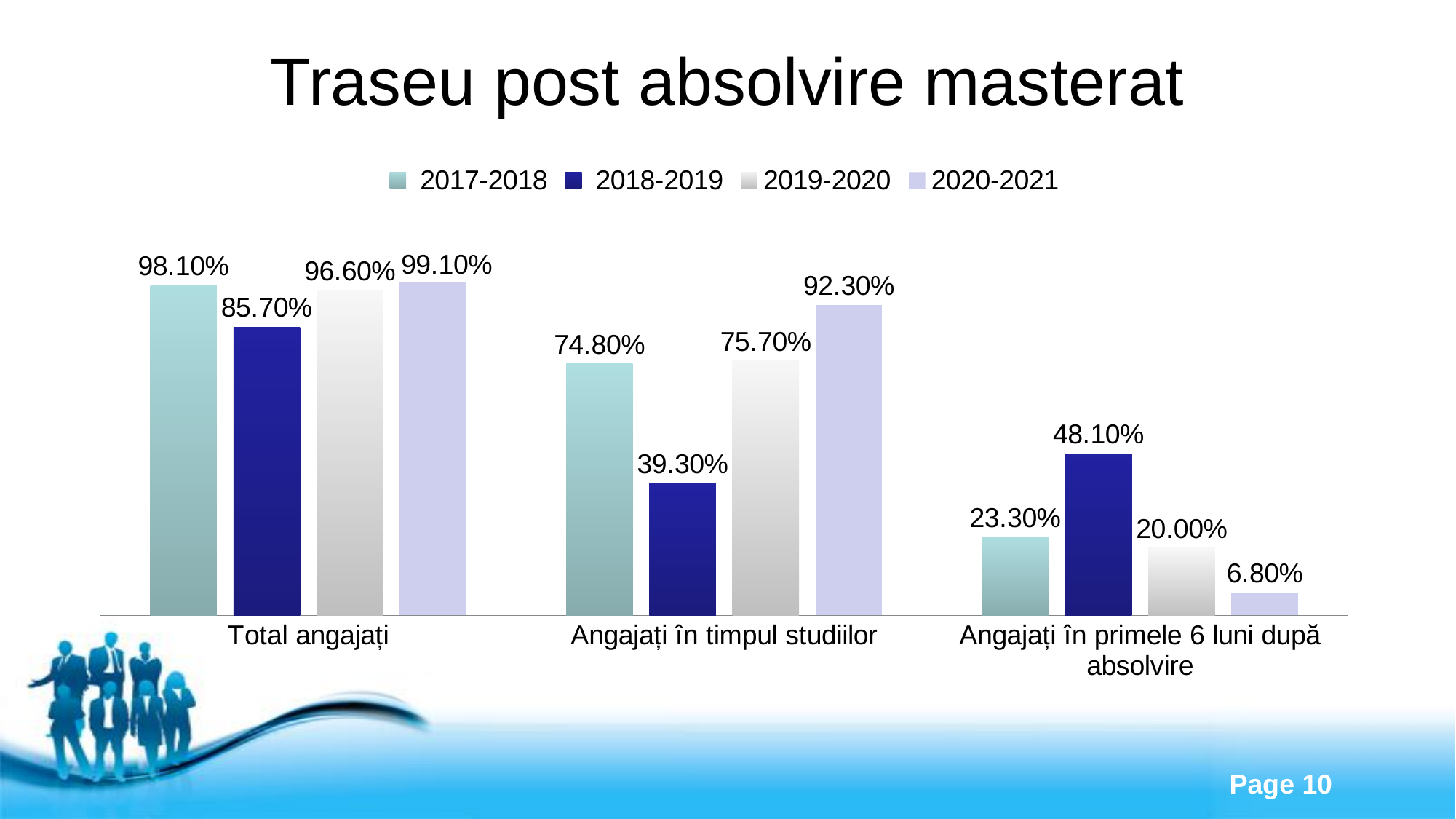
What is the difference between the 2020-2021 and 2018-2019 values in the Angajați în timpul studiilor category? 53.00% How many categories are shown on the x axis? 3 Which series has the lowest value in the Total angajați category? 2018-2019 Which is larger in the Total angajați category: the 2017-2018 value or the 2019-2020 value? 2017-2018 Which series has the highest value in the Angajați în primele 6 luni după absolvire category? 2018-2019 What is the value for 2018-2019 in the Angajați în timpul studiilor category? 39.30% What is the title of the slide? Traseu post absolvire masterat What is the value for 2020-2021 in the Total angajați category? 99.10% What is the difference between the 2017-2018 and 2020-2021 values in the Angajați în primele 6 luni după absolvire category? 16.50% How many series does the legend list? 4 What kind of chart is shown on the slide? Bar chart What is the value for 2019-2020 in the Angajați în primele 6 luni după absolvire category? 20.00%